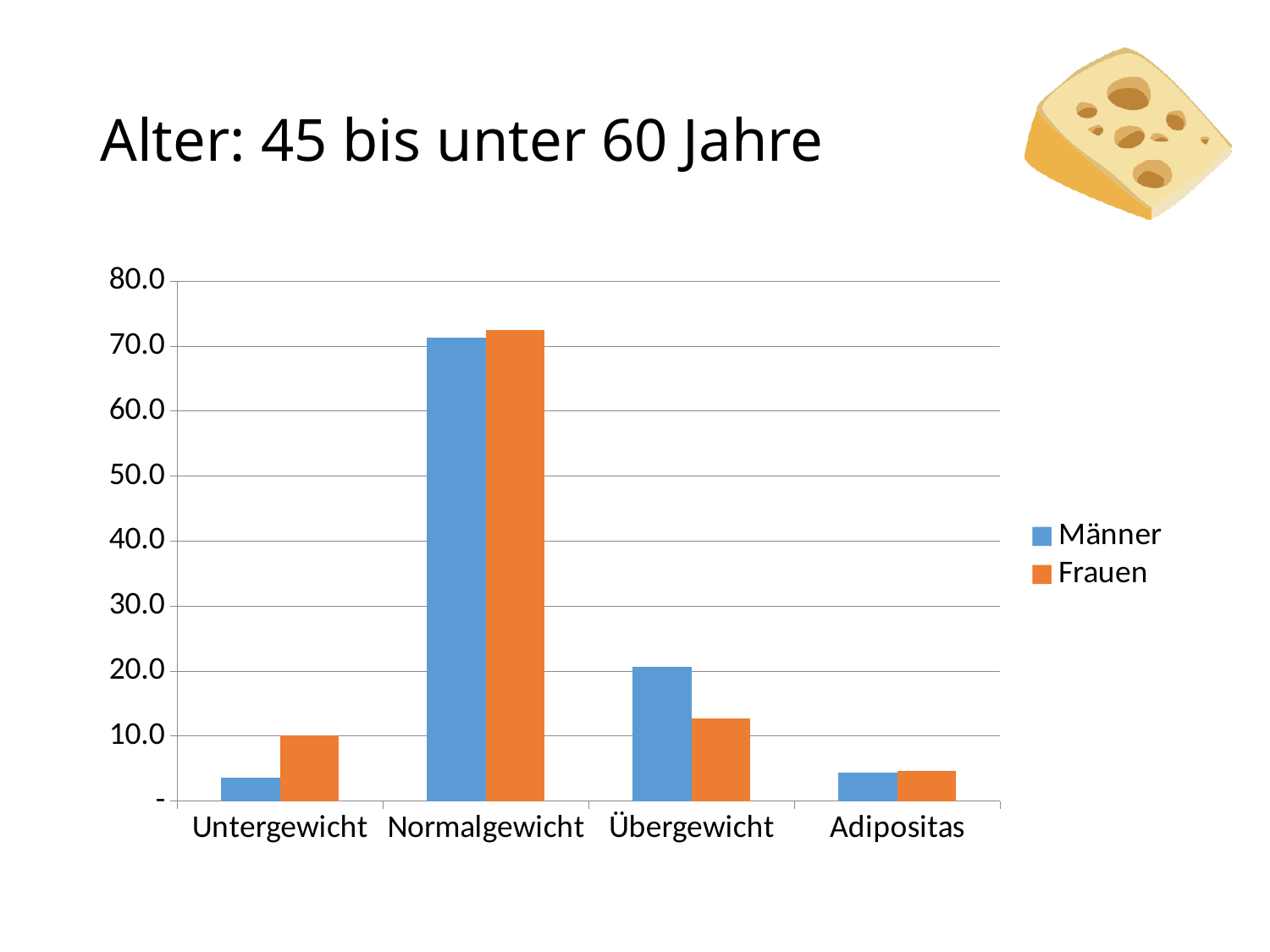
For Übergewicht, which series has the larger value, Männer or Frauen? Männer Which colour represents the Frauen series? orange Is the value for Männer in Normalgewicht greater or less than 60.0? greater Is the value for Frauen in Übergewicht greater or less than 20.0? less How many series does the legend list? 2 Which category has the highest value for Frauen? Normalgewicht For Untergewicht, which series has the larger value, Männer or Frauen? Frauen What is the title of the slide? Alter: 45 bis unter 60 Jahre How many categories are shown on the x axis? 4 Which category has the highest value for Männer? Normalgewicht Which category has the lowest value for Männer? Untergewicht What kind of chart is shown on the slide? bar chart